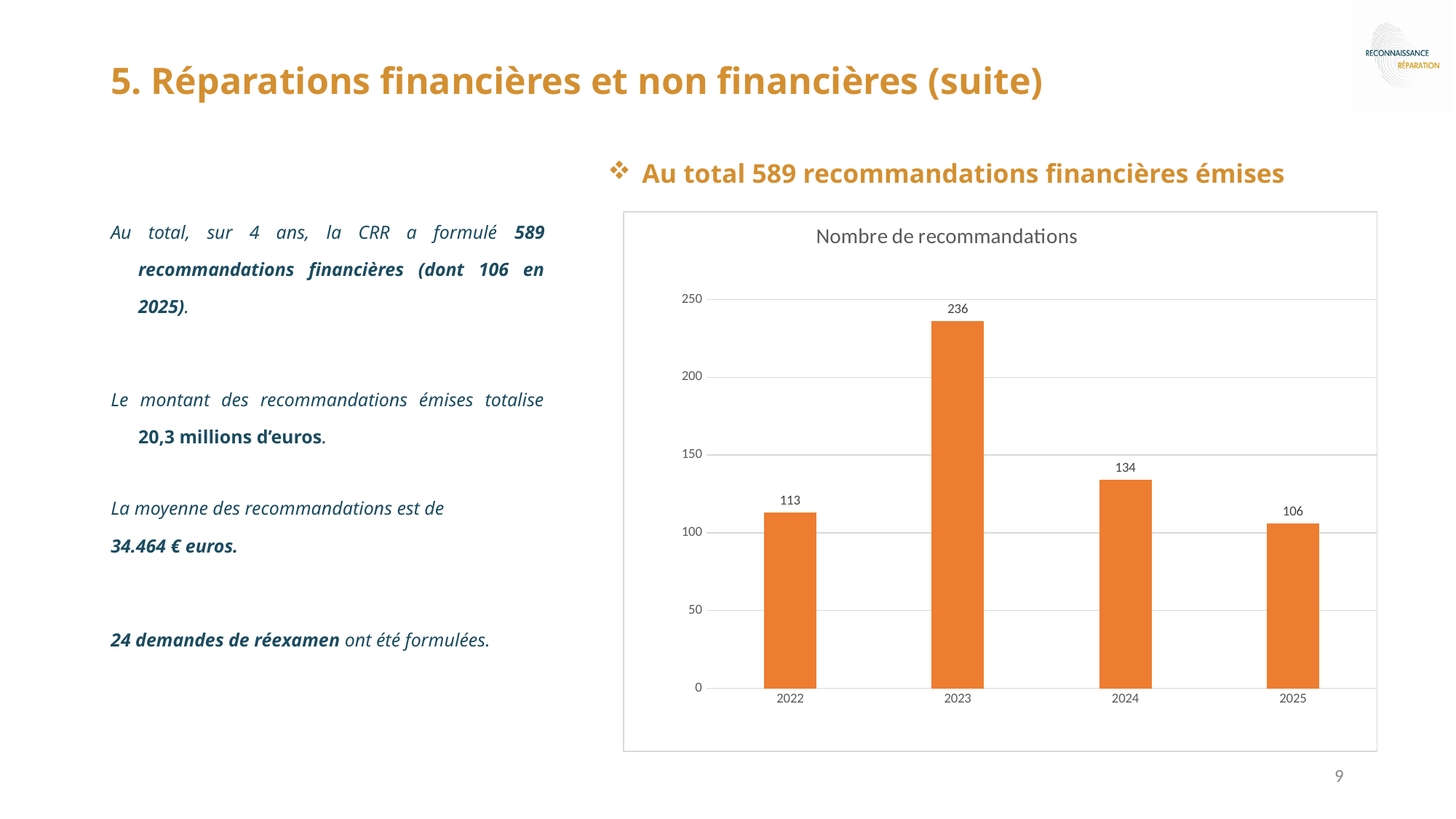
What is the number of recommendations for 2025? 106 What is the number of recommendations for 2022? 113 Which year has the highest number of recommendations? 2023 Is the value for 2024 greater or less than 150? less How many years are shown on the x axis of the chart? 4 What is the difference between the number of recommendations in 2022 and 2025? 7 What is the difference between the number of recommendations in 2023 and 2024? 102 What is the title of the chart? Nombre de recommandations Which year has more recommendations, 2022 or 2024? 2024 What is the number of recommendations for 2023? 236 What kind of chart is shown on the slide? bar chart Which year has the lowest number of recommendations? 2025